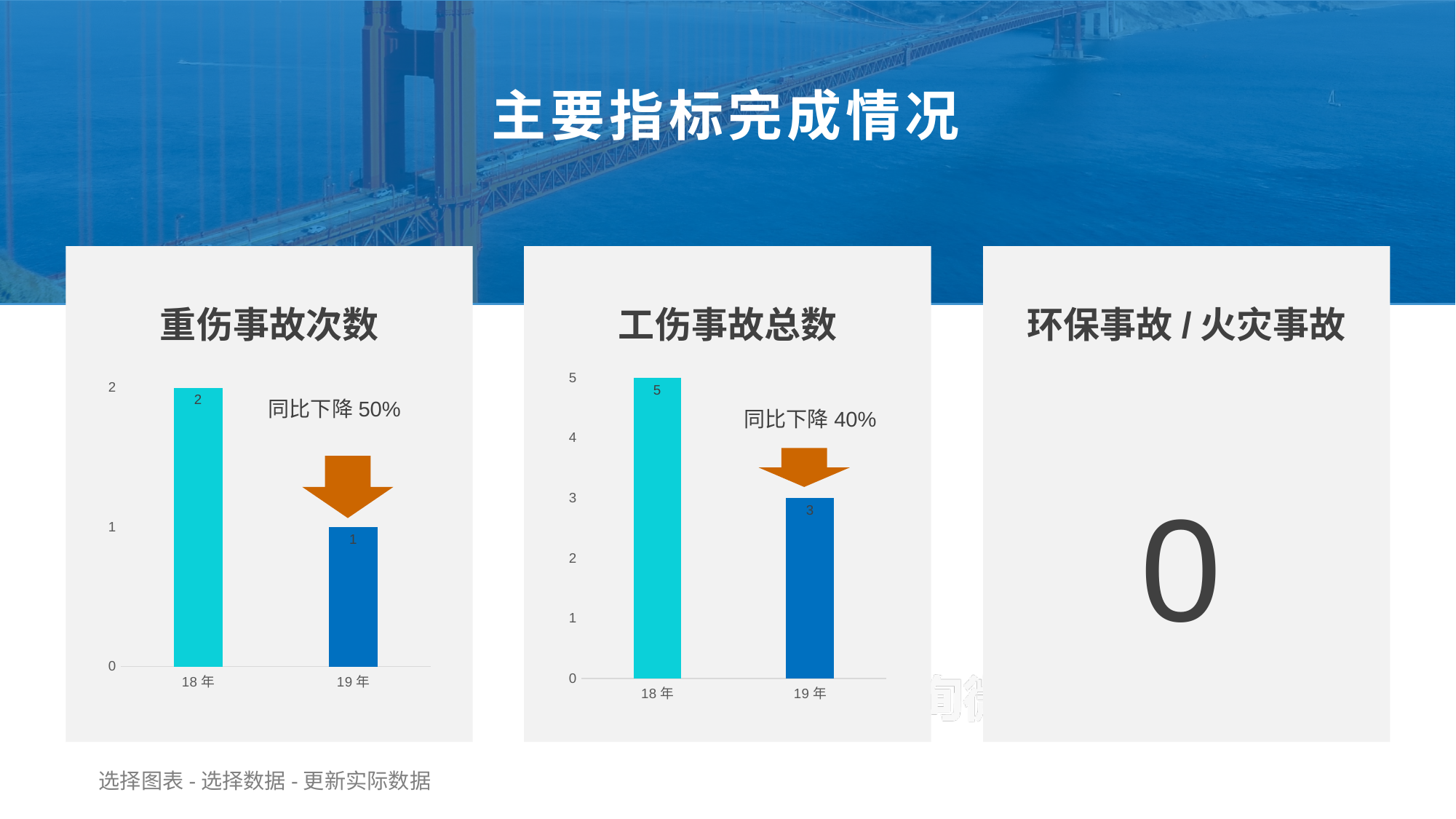
In the 工伤事故总数 chart, which year has the highest value? 18 年 In the 重伤事故次数 chart, what is the value for 19 年? 1 In the 工伤事故总数 chart, what is the difference between the values for 18 年 and 19 年? 2 In the 重伤事故次数 chart, which is larger, the value for 18 年 or 19 年? 18 年 In the 工伤事故总数 chart, do the values rise or fall from 18 年 to 19 年? fall What percentage decrease is annotated on the 工伤事故总数 chart? 同比下降 40% In the 重伤事故次数 chart, which year has the lowest value? 19 年 In the 工伤事故总数 chart, what is the value for 19 年? 3 In the 重伤事故次数 chart, what is the value for 18 年? 2 How many categories are shown on the x axis of the 工伤事故总数 chart? 2 In the 工伤事故总数 chart, what is the value for 18 年? 5 What kind of chart is the 重伤事故次数 chart? bar chart